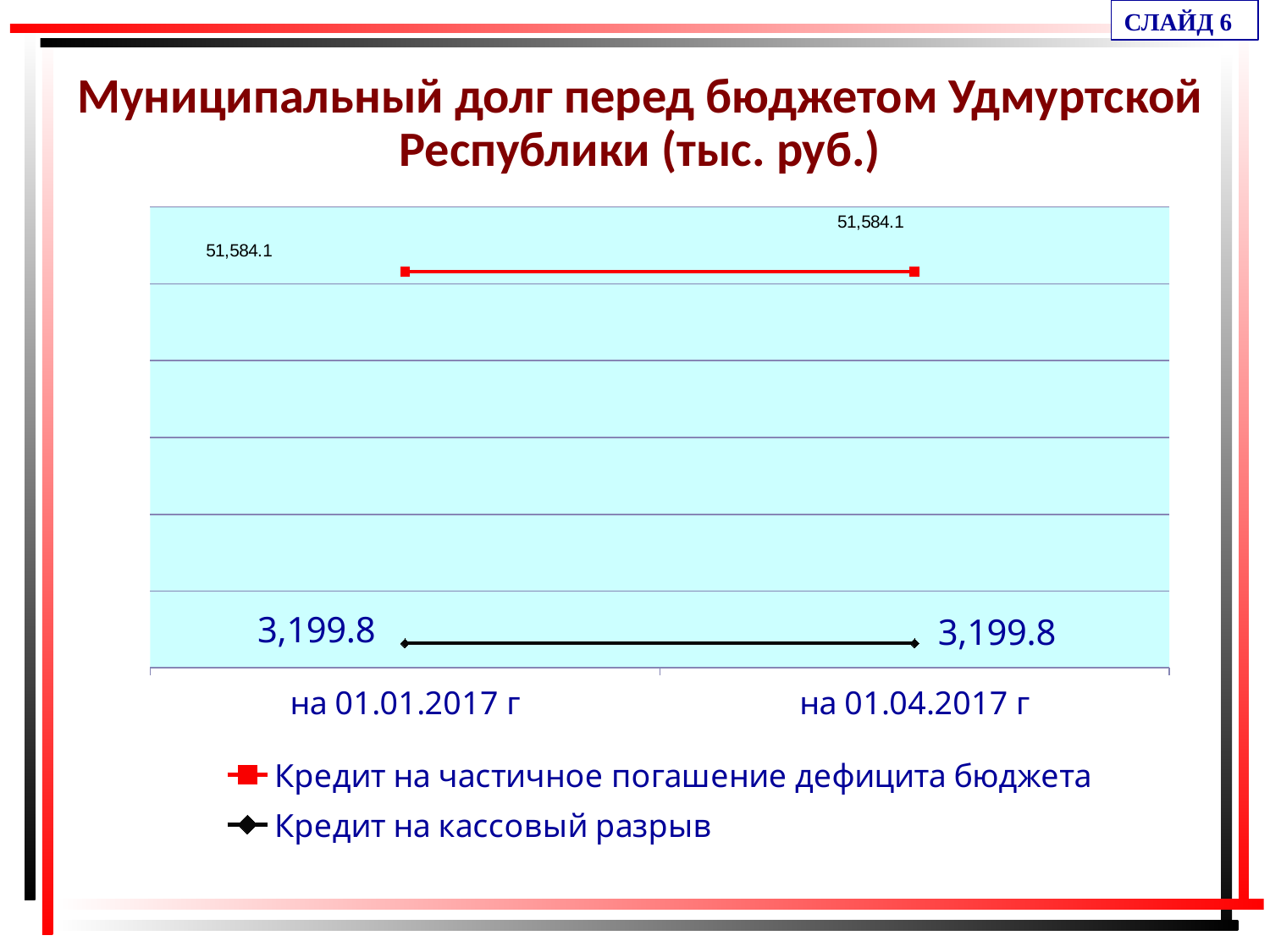
What is the value of "Кредит на частичное погашение дефицита бюджета" на 01.01.2017 г? 51,584.1 What colour is the line for "Кредит на частичное погашение дефицита бюджета"? Red What is the value of "Кредит на частичное погашение дефицита бюджета" на 01.04.2017 г? 51,584.1 How many dates are shown on the x axis? 2 What is the difference between the two series' values на 01.01.2017 г? 48,384.3 Does the value of "Кредит на кассовый разрыв" rise, fall or stay the same from 01.01.2017 to 01.04.2017? Stays the same What is the value of "Кредит на кассовый разрыв" на 01.04.2017 г? 3,199.8 What is the title of the chart? Муниципальный долг перед бюджетом Удмуртской Республики (тыс. руб.) How many series does the legend list? 2 What kind of chart is shown on the slide? Line chart What is the value of "Кредит на кассовый разрыв" на 01.01.2017 г? 3,199.8 Which series has the higher value на 01.04.2017 г? Кредит на частичное погашение дефицита бюджета